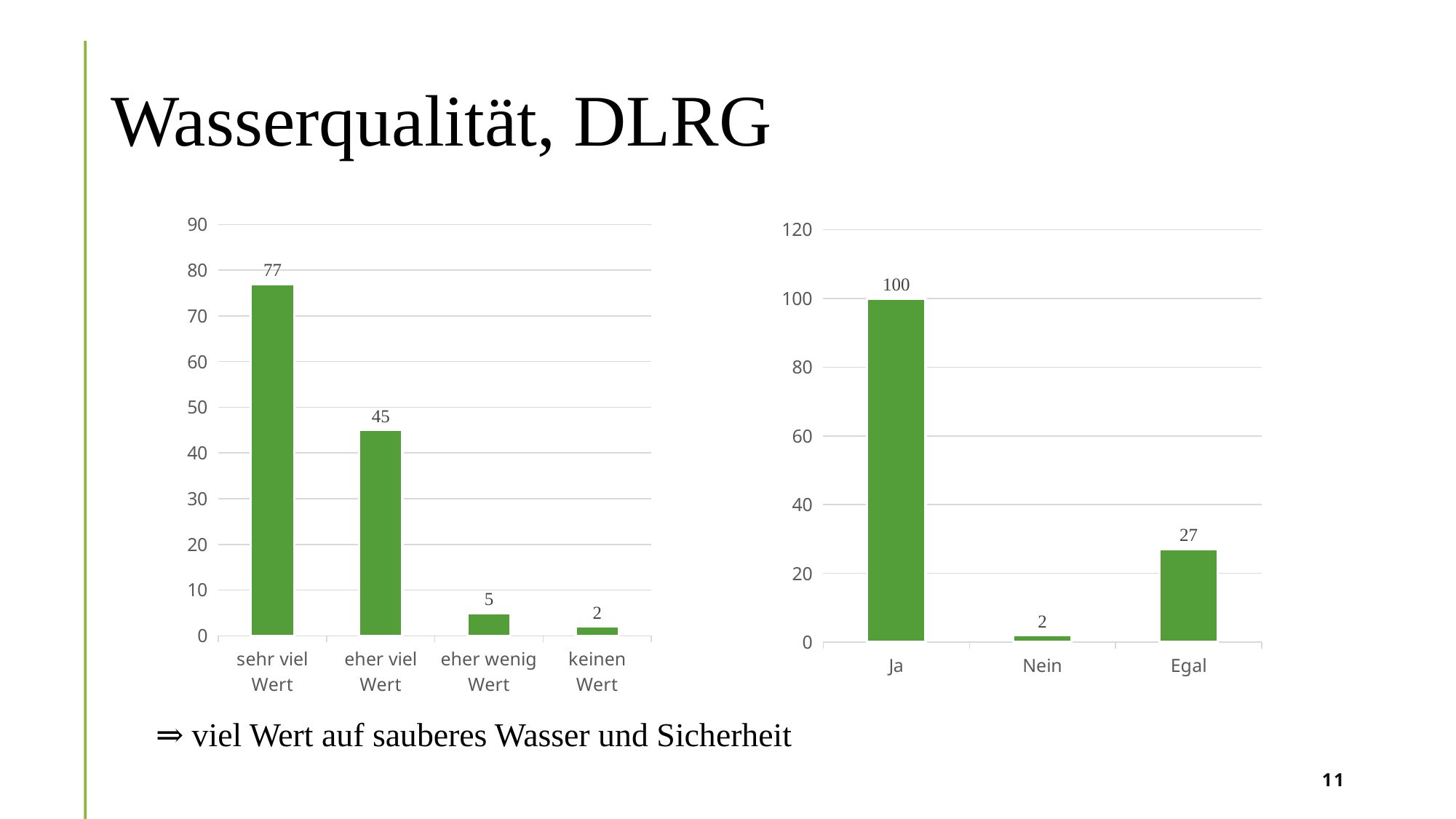
In the right chart, which is larger, the value for "Nein" or the value for "Egal"? Egal In the right chart, what is the difference between "Ja" and "Egal"? 73 In the left chart, what is the value for "eher viel Wert"? 45 In the left chart, which category has the lowest value? keinen Wert What kind of chart is the right chart? bar chart In the right chart, which category has the highest value? Ja In the left chart, what is the difference between "sehr viel Wert" and "eher viel Wert"? 32 In the right chart, what is the value for "Ja"? 100 In the right chart, what is the value for "Egal"? 27 In the left chart, how many categories are shown on the x axis? 4 In the left chart, what is the value for "sehr viel Wert"? 77 In the left chart, do the values rise or fall from left to right along the x axis? fall